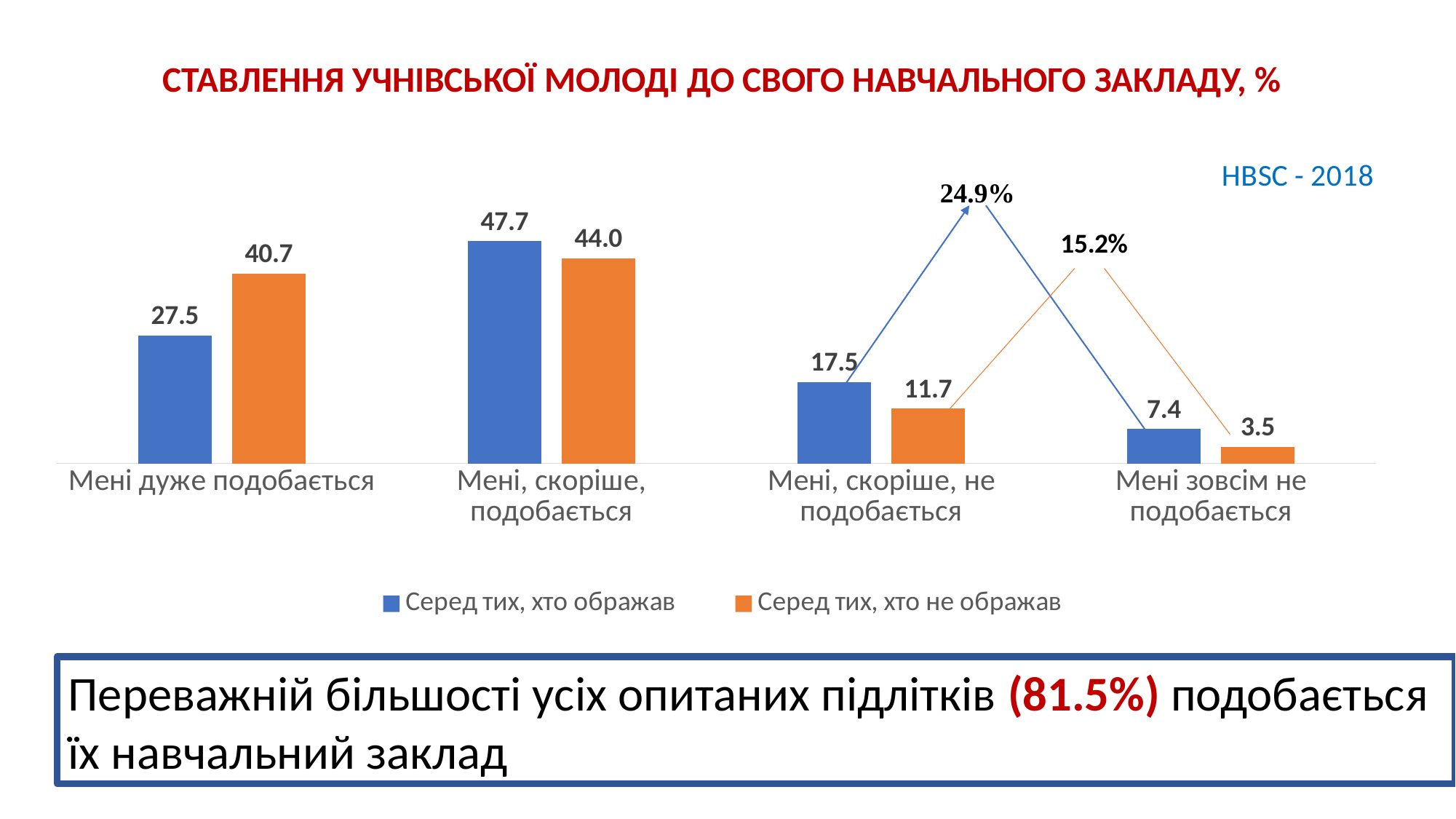
What is the value for "Серед тих, хто не ображав" in the category "Мені зовсім не подобається"? 3.5 Which category has the lowest value for the series "Серед тих, хто не ображав"? Мені зовсім не подобається What is the difference between the two series in the category "Мені дуже подобається"? 13.2 Which colour represents the series "Серед тих, хто не ображав"? Orange What is the combined value of the two "not like" categories for the series "Серед тих, хто ображав", as annotated on the chart? 24.9% What kind of chart is shown on the slide? Bar chart How many categories are shown on the x axis? 4 What is the value for "Серед тих, хто ображав" in the category "Мені дуже подобається"? 27.5 Which category has the highest value for the series "Серед тих, хто ображав"? Мені, скоріше, подобається What is the value for "Серед тих, хто не ображав" in the category "Мені, скоріше, подобається"? 44.0 How many series does the legend list? 2 In the category "Мені, скоріше, не подобається", which series has the larger value? Серед тих, хто ображав